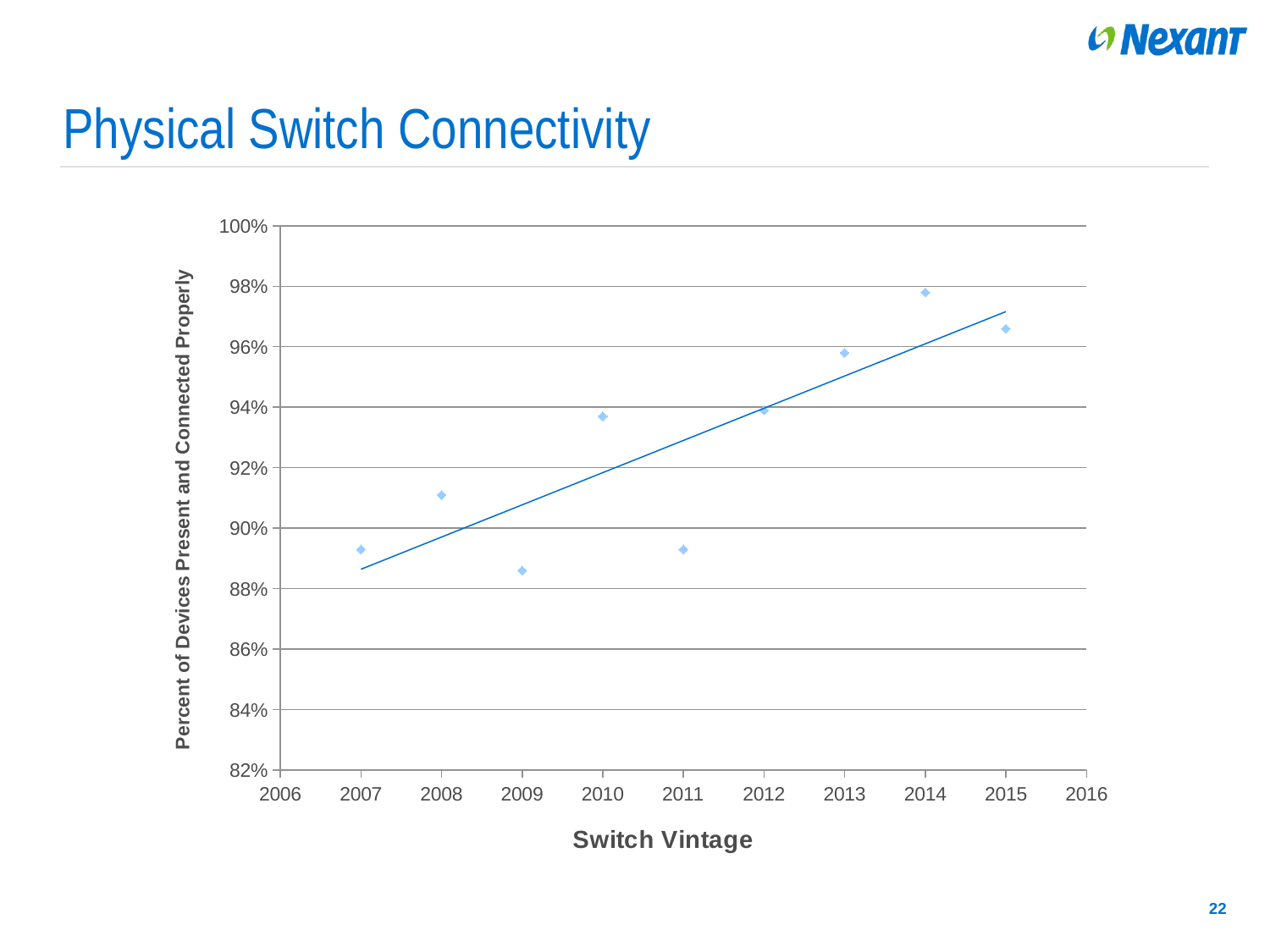
Does the trend line show the percent of devices present and connected properly rising or falling with switch vintage? rising Which switch vintage has the highest percent of devices present and connected properly? 2014 Which switch vintage has the lowest percent of devices present and connected properly? 2009 Is the value for the 2014 switch vintage greater or less than 96%? greater How many data points are plotted on the chart? 9 Is the value for the 2008 switch vintage greater or less than 90%? greater What kind of chart is shown on the slide? scatter chart What is the label of the x axis? Switch Vintage Is the value for the 2009 switch vintage greater or less than 90%? less Which has a higher percent of devices present and connected properly, the 2010 or the 2011 switch vintage? 2010